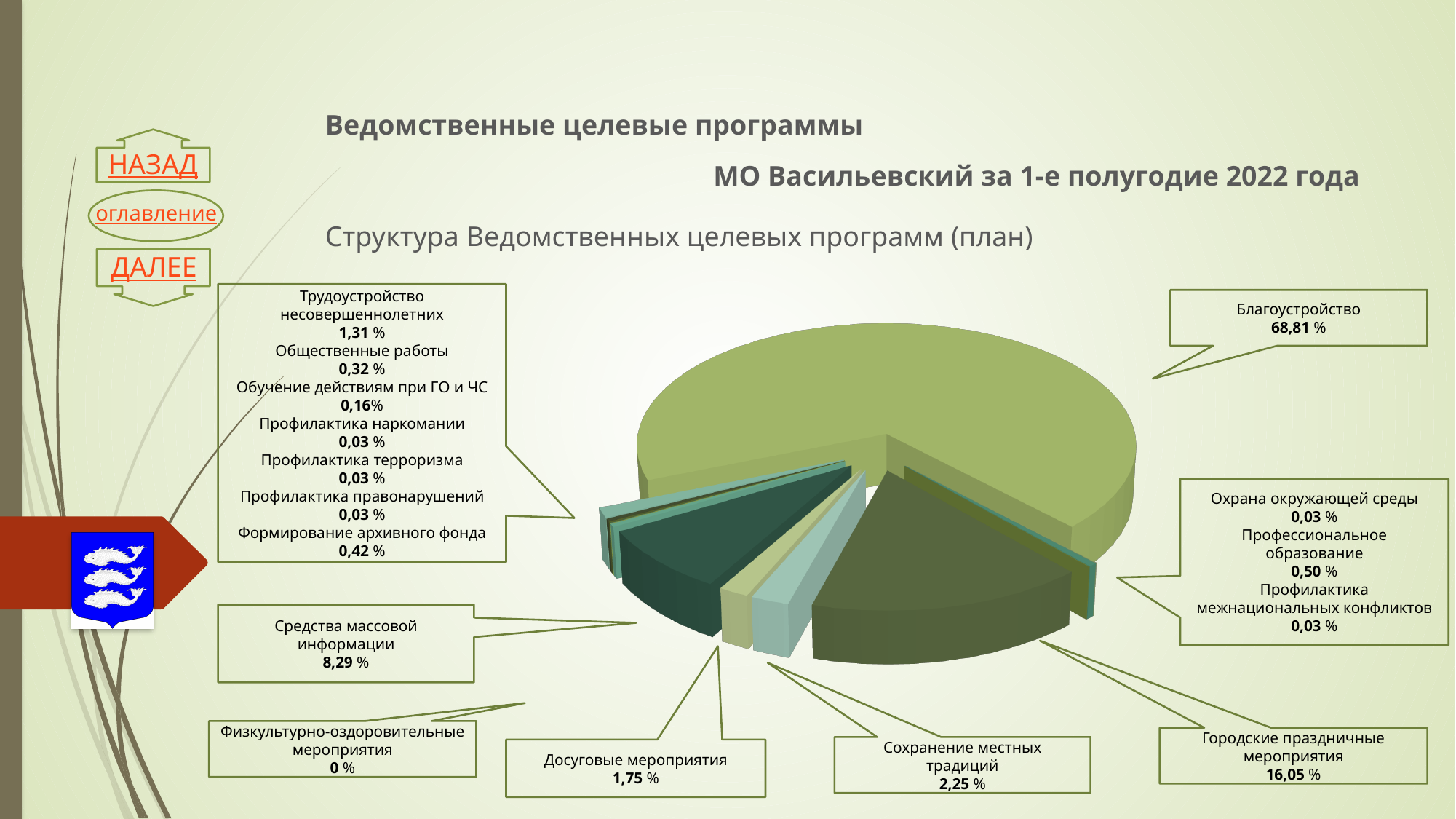
Which category has the largest share of the pie? Благоустройство What is the value for Формирование архивного фонда? 0,42 % Which category has the smallest value? Физкультурно-оздоровительные мероприятия What kind of chart is shown on the slide? Pie chart What is the value for Благоустройство? 68,81 % What is the value for Городские праздничные мероприятия? 16,05 % What is the value for Досуговые мероприятия? 1,75 % What is the difference between Благоустройство and Городские праздничные мероприятия? 52,76 % What is the subtitle of the chart? Структура Ведомственных целевых программ (план) What is the difference between Сохранение местных традиций and Досуговые мероприятия? 0,50 % What is the value for Средства массовой информации? 8,29 % Which is larger: Средства массовой информации or Сохранение местных традиций? Средства массовой информации